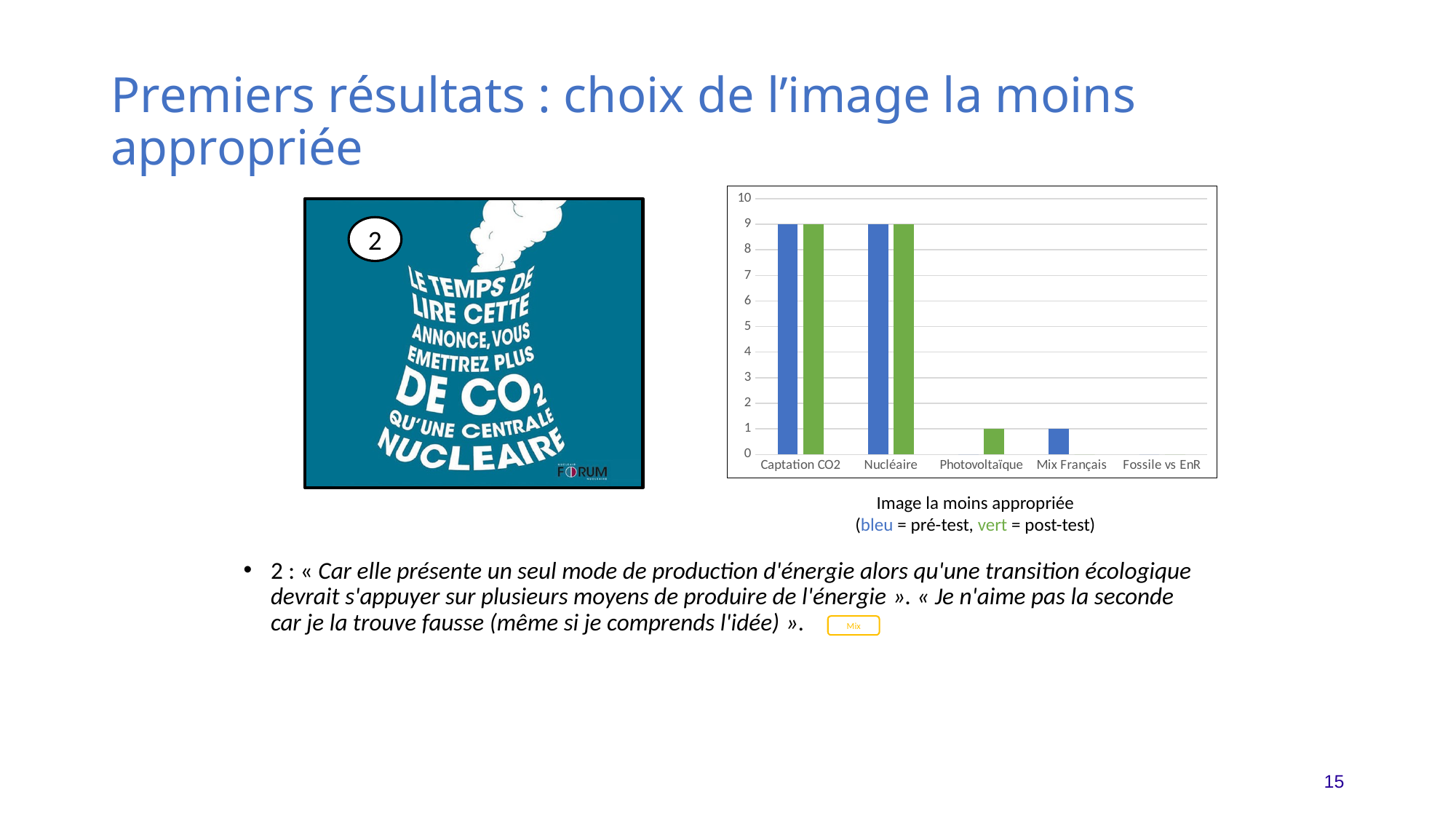
What is the caption title given under the chart? Image la moins appropriée What is the post-test (green) value for Photovoltaïque? 1 How many categories are shown on the x axis of the chart? 5 What kind of chart is shown on the slide? bar chart According to the caption under the chart, which colour represents the post-test? vert (green) What is the pré-test (blue) value for Mix Français? 1 Which is larger: the post-test value for Captation CO2 or the post-test value for Photovoltaïque? Captation CO2 Which category has the lowest values in the chart, with no visible bars at all? Fossile vs EnR What is the post-test (green) value for Nucléaire? 9 What is the pré-test (blue) value for Captation CO2? 9 What is the difference between the pré-test value for Nucléaire and the pré-test value for Mix Français? 8 Is the pré-test value for Nucléaire greater or less than 5? greater